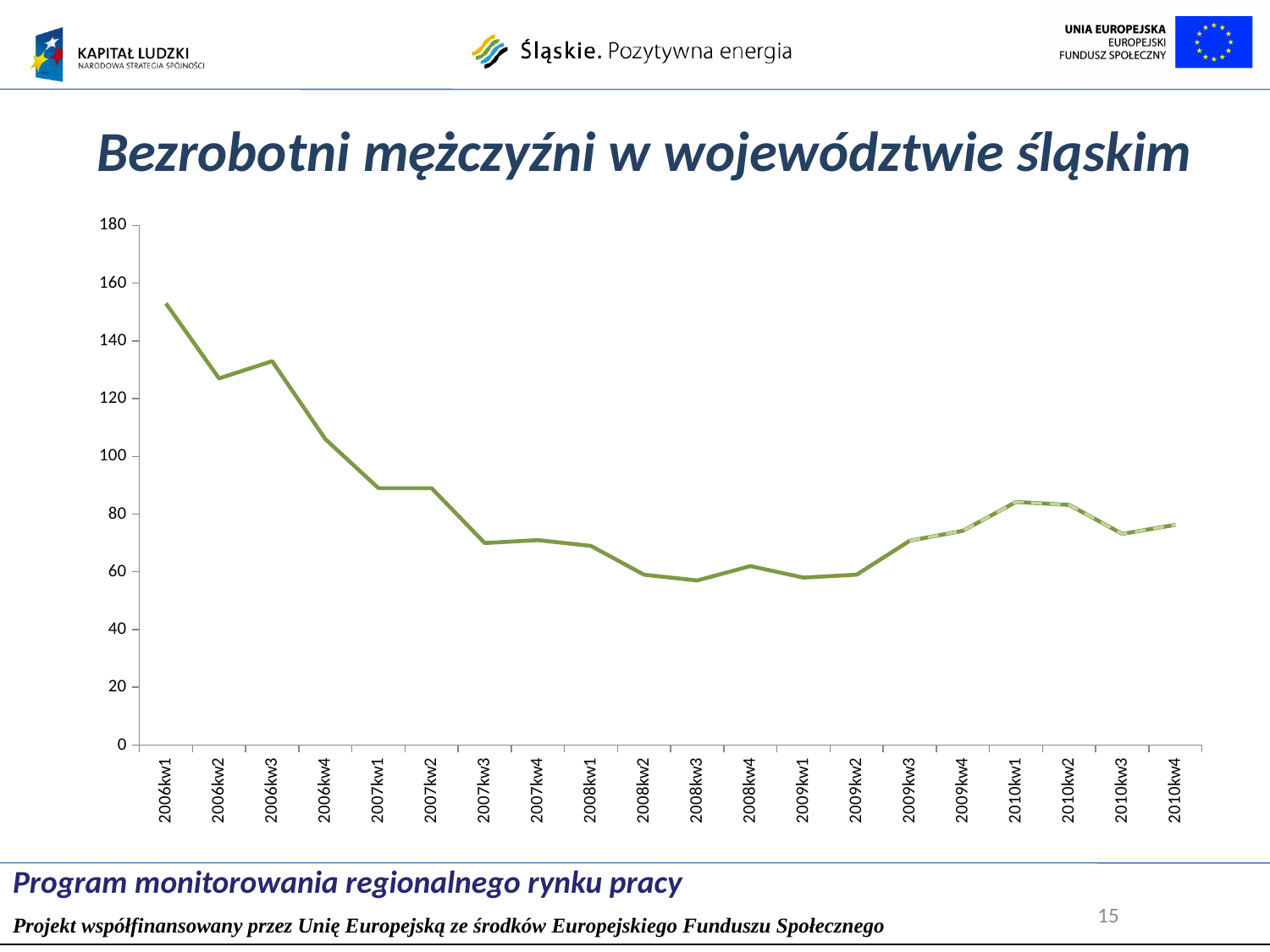
What is the highest value shown on the vertical axis? 180 Is the value for 2007kw1 greater or less than 100? less How many quarterly data points are plotted on the chart? 20 Do the values rise or fall from 2006kw1 to 2008kw3? fall What is the title of the chart? Bezrobotni mężczyźni w województwie śląskim Is the value for 2010kw1 greater or less than 80? greater Which quarter has the highest value on the chart? 2006kw1 Which is larger, the value for 2010kw1 or the value for 2010kw3? 2010kw1 Which is larger, the value for 2006kw4 or the value for 2007kw3? 2006kw4 What kind of chart is shown on the slide? line chart Is the value for 2006kw1 greater or less than 140? greater